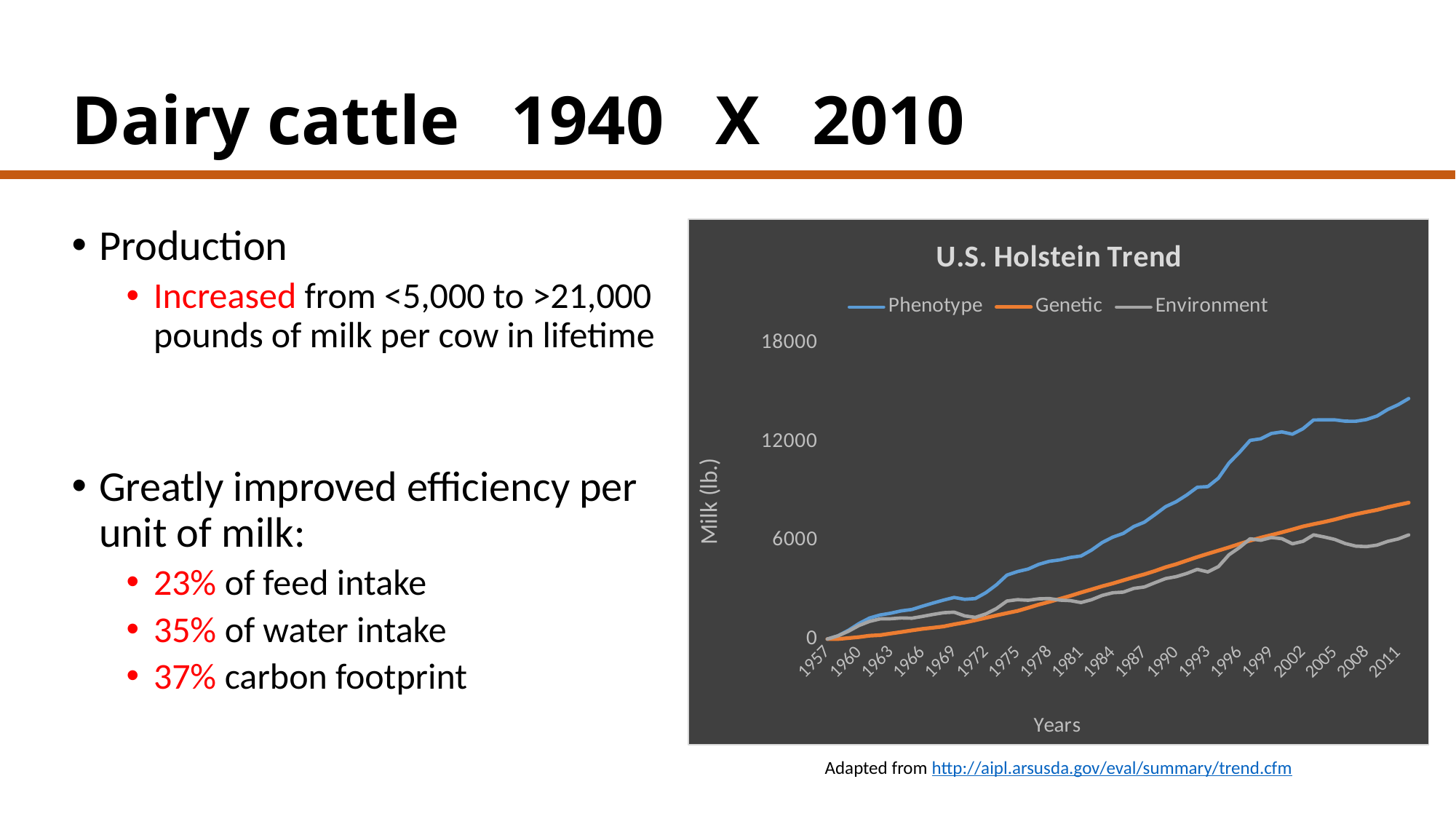
What are the three series named in the legend of the U.S. Holstein Trend chart? Phenotype, Genetic, Environment In the U.S. Holstein Trend chart, which is larger in 2011: the Genetic value or the Environment value? Genetic Which series has the highest value in 2011 in the U.S. Holstein Trend chart? Phenotype What is the y-axis label of the U.S. Holstein Trend chart? Milk (lb.) Is the Genetic value for 2011 in the U.S. Holstein Trend chart greater or less than 12000? less Does the Phenotype line in the U.S. Holstein Trend chart rise or fall from 1957 to 2011? rise Is the Phenotype value for 2011 in the U.S. Holstein Trend chart greater or less than 12000? greater How many series does the legend of the U.S. Holstein Trend chart list? 3 Does the Genetic line in the U.S. Holstein Trend chart rise or fall over the years shown? rise Is the Genetic value for 1981 in the U.S. Holstein Trend chart greater or less than 6000? less How many year labels are shown on the x axis of the U.S. Holstein Trend chart? 19 What kind of chart is the U.S. Holstein Trend chart? line chart